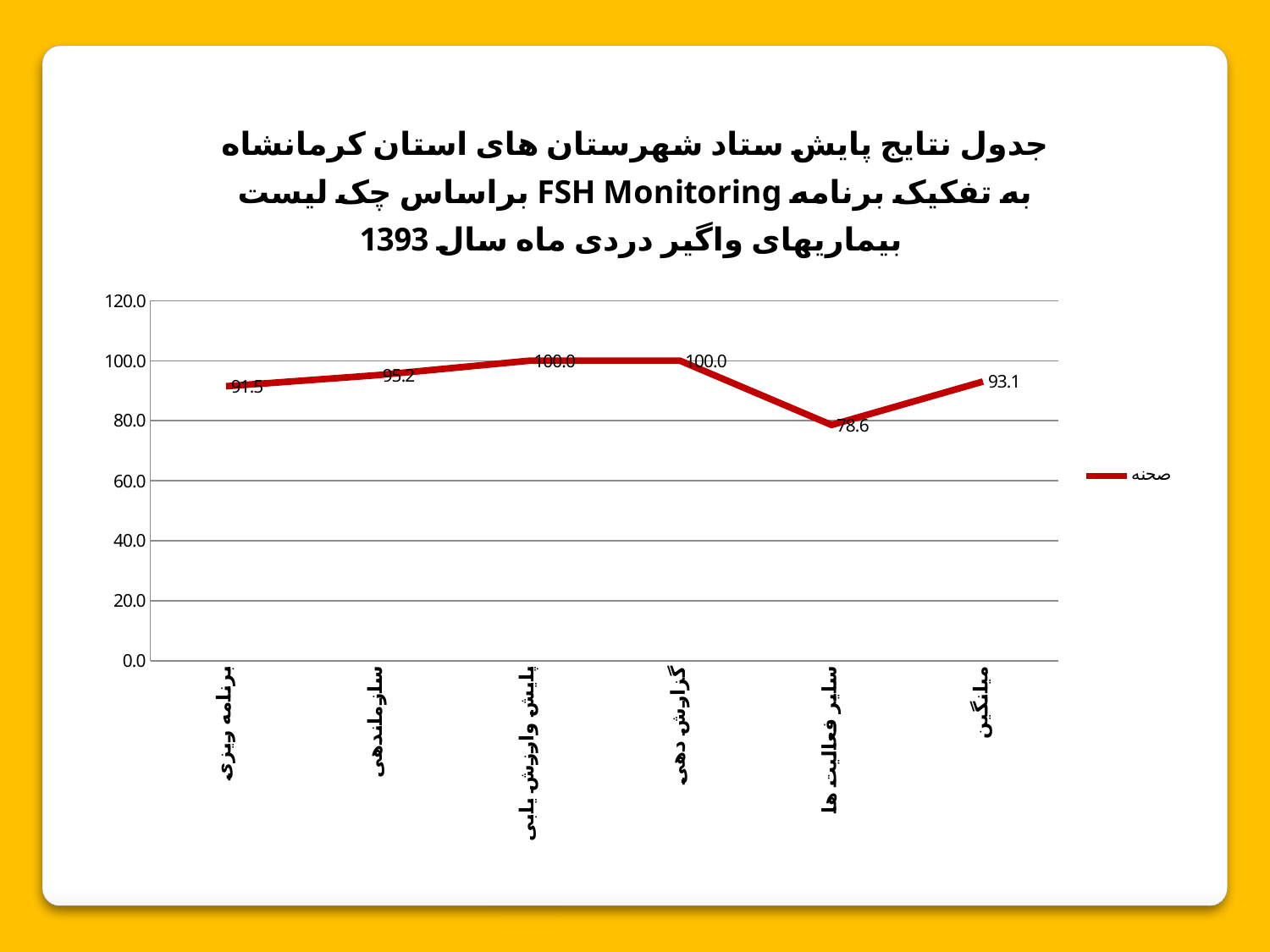
How many categories are shown on the x axis? 6 What kind of chart is shown on the slide? line chart What is the value for سایر فعالیت ها? 78.6 How many series does the legend list? 1 Which category has the lowest value? سایر فعالیت ها What is the difference between the values for گزارش دهی and سایر فعالیت ها? 21.4 What is the value for سازماندهی? 95.2 What is the difference between the values for سازماندهی and برنامه ریزی? 3.7 What is the value for برنامه ریزی? 91.5 Is the value for سایر فعالیت ها greater or less than 80.0? less Which is larger, the value for میانگین or the value for سایر فعالیت ها? میانگین What is the value for میانگین? 93.1